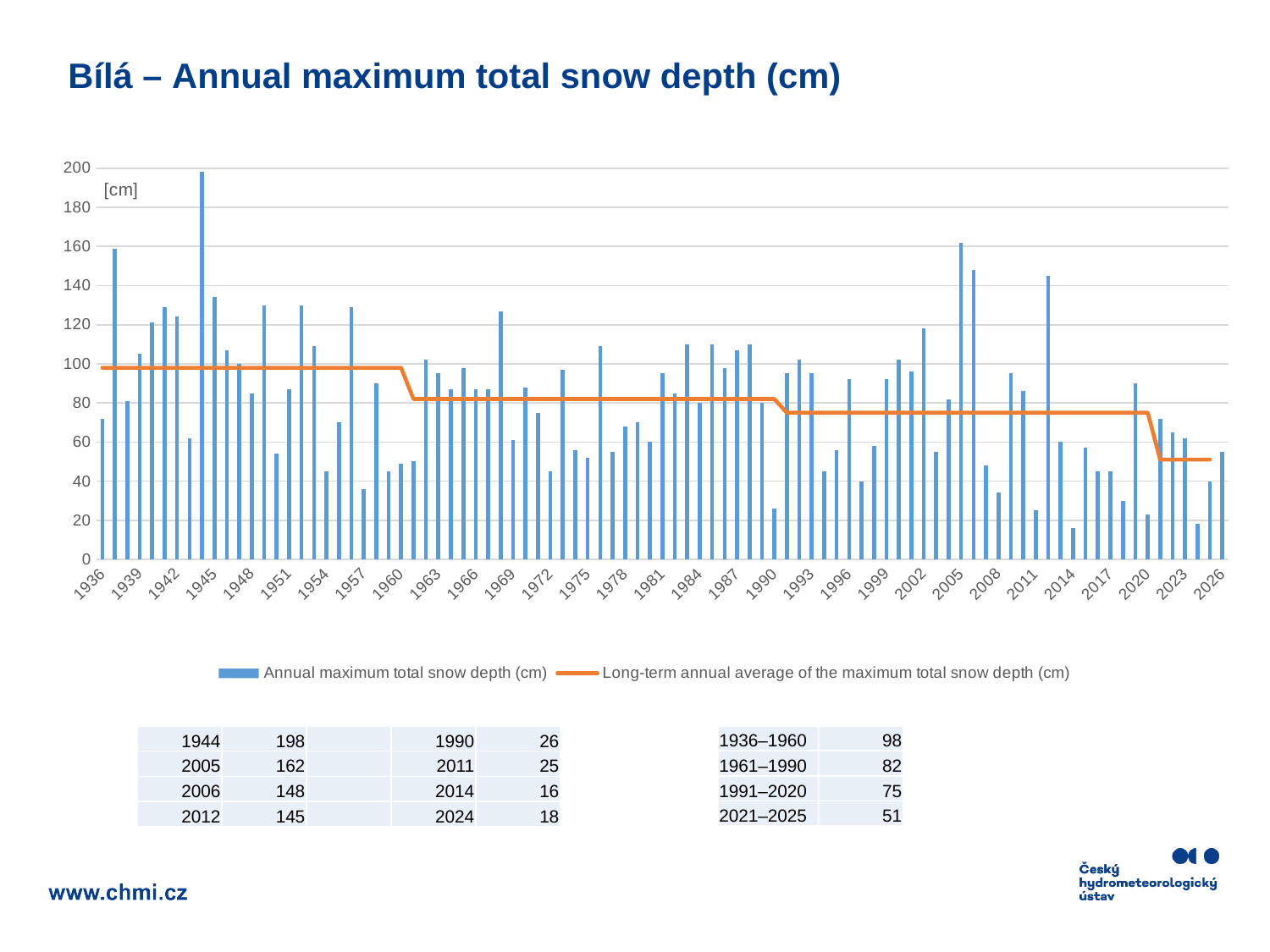
What kind of chart is used to show the annual maximum total snow depth? bar chart What is the difference between the long-term average for 1936–1960 and for 2021–2025? 47 Which year has the lowest annual maximum total snow depth? 2014 What is the difference between the annual maximum total snow depth in 1944 and in 2005? 36 Is the annual maximum total snow depth for 1937 greater or less than 140? greater How many series does the legend list? 2 Does the long-term annual average of the maximum total snow depth rise or fall from 1936 to 2025? fall What is the annual maximum total snow depth for 2024? 18 What is the long-term annual average of the maximum total snow depth for the period 1961–1990? 82 What is the annual maximum total snow depth for 1944? 198 Which year has the highest annual maximum total snow depth? 1944 Which year has a larger annual maximum total snow depth, 2005 or 2006? 2005